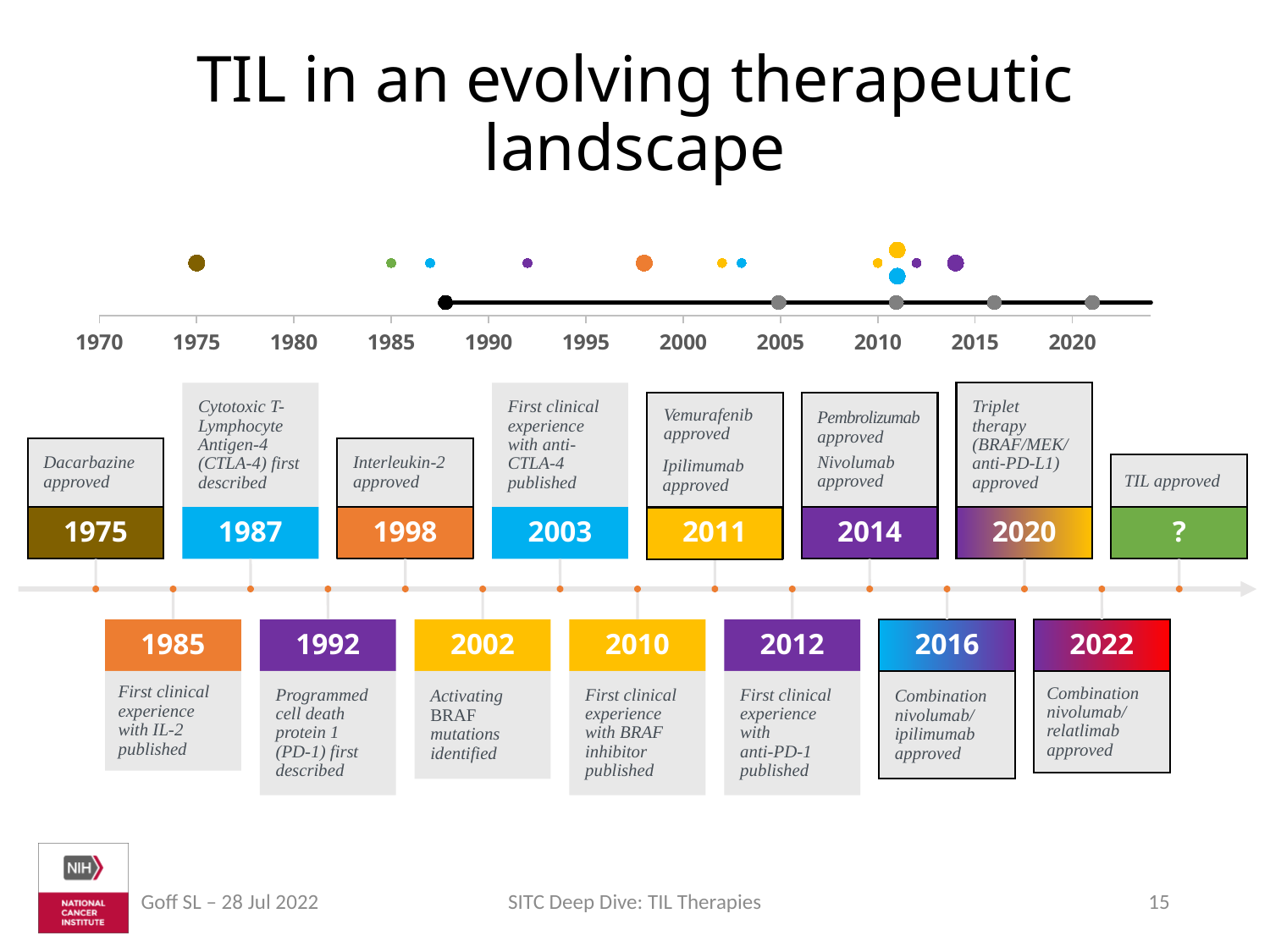
In the top dot chart, is the brown dot positioned at a year greater or less than 1980? less In the top dot chart, is the large orange dot positioned at a year greater or less than 1995? greater In the top dot chart, which is positioned at an earlier year: the brown dot or the green dot? the brown dot On the lower timeline, what year is shown for 'Pembrolizumab approved' and 'Nivolumab approved'? 2014 In the top dot chart, is the large purple dot positioned at a year greater or less than 2010? greater In the top dot chart, what is the first year label on the x axis? 1970 What kind of chart is the plot at the top of the slide, with coloured dots above a year axis? scatter chart On the lower timeline, what is shown in the year box for 'TIL approved'? ? In the top dot chart, how many year tick labels are shown on the x axis? 11 On the lower timeline, what year is shown for 'Dacarbazine approved'? 1975 In the top dot chart, what is the last year label on the x axis? 2020